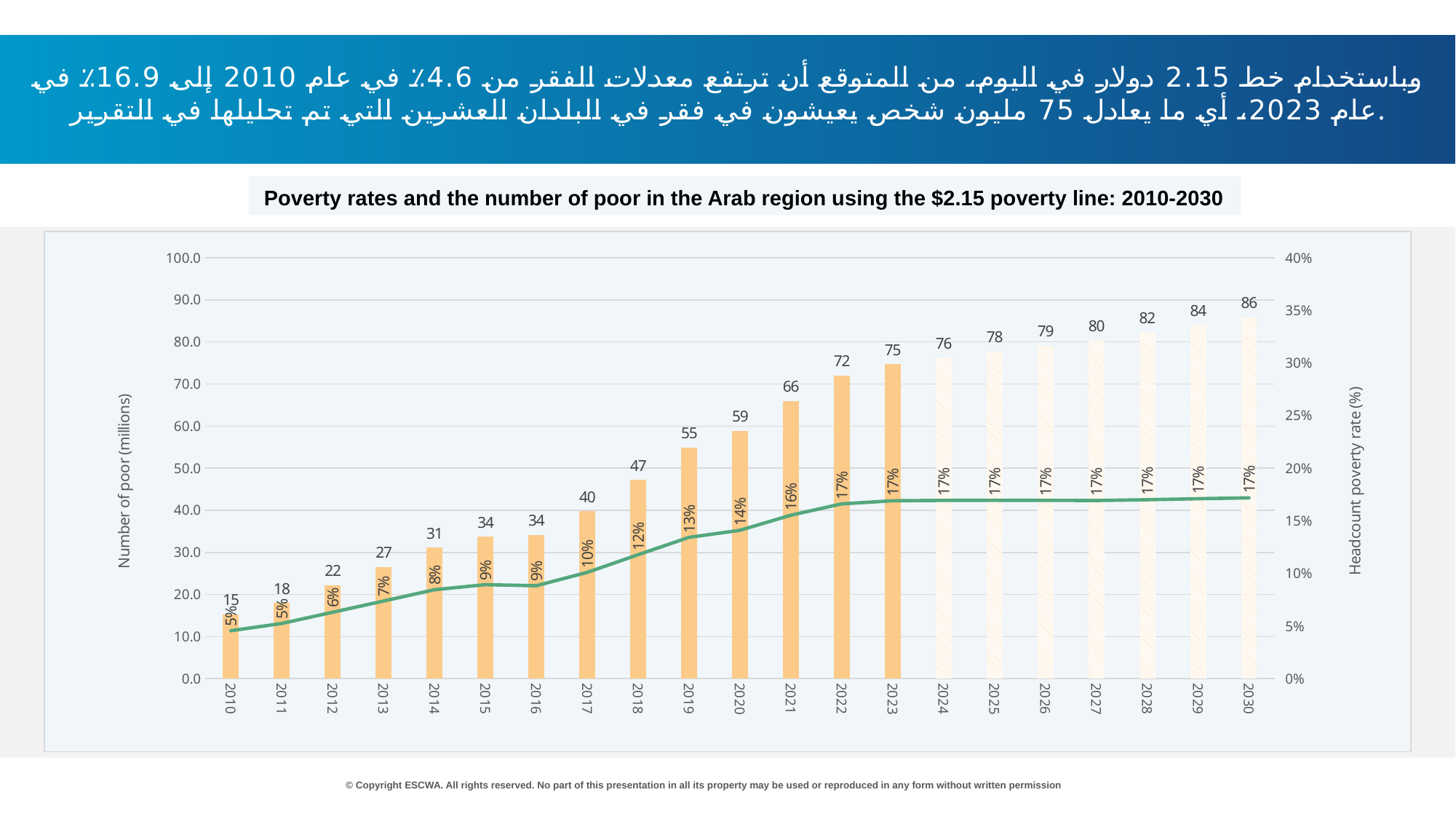
What is the number of poor (millions) shown for 2030? 86 What kind of chart is this? Bar chart with a line Which year has the highest number of poor? 2030 What headcount poverty rate is labelled on the bar for 2018? 12% Which year has a larger number of poor, 2019 or 2021? 2021 What headcount poverty rate is labelled on the bar for 2010? 5% What is the title of the chart? Poverty rates and the number of poor in the Arab region using the $2.15 poverty line: 2010-2030 What is the difference in the number of poor (millions) between 2023 and 2010? 60 Does the number of poor rise or fall from 2010 to 2030? Rise What is the number of poor (millions) shown for 2023? 75 Which year has the lowest number of poor? 2010 How many years are shown on the x axis? 21